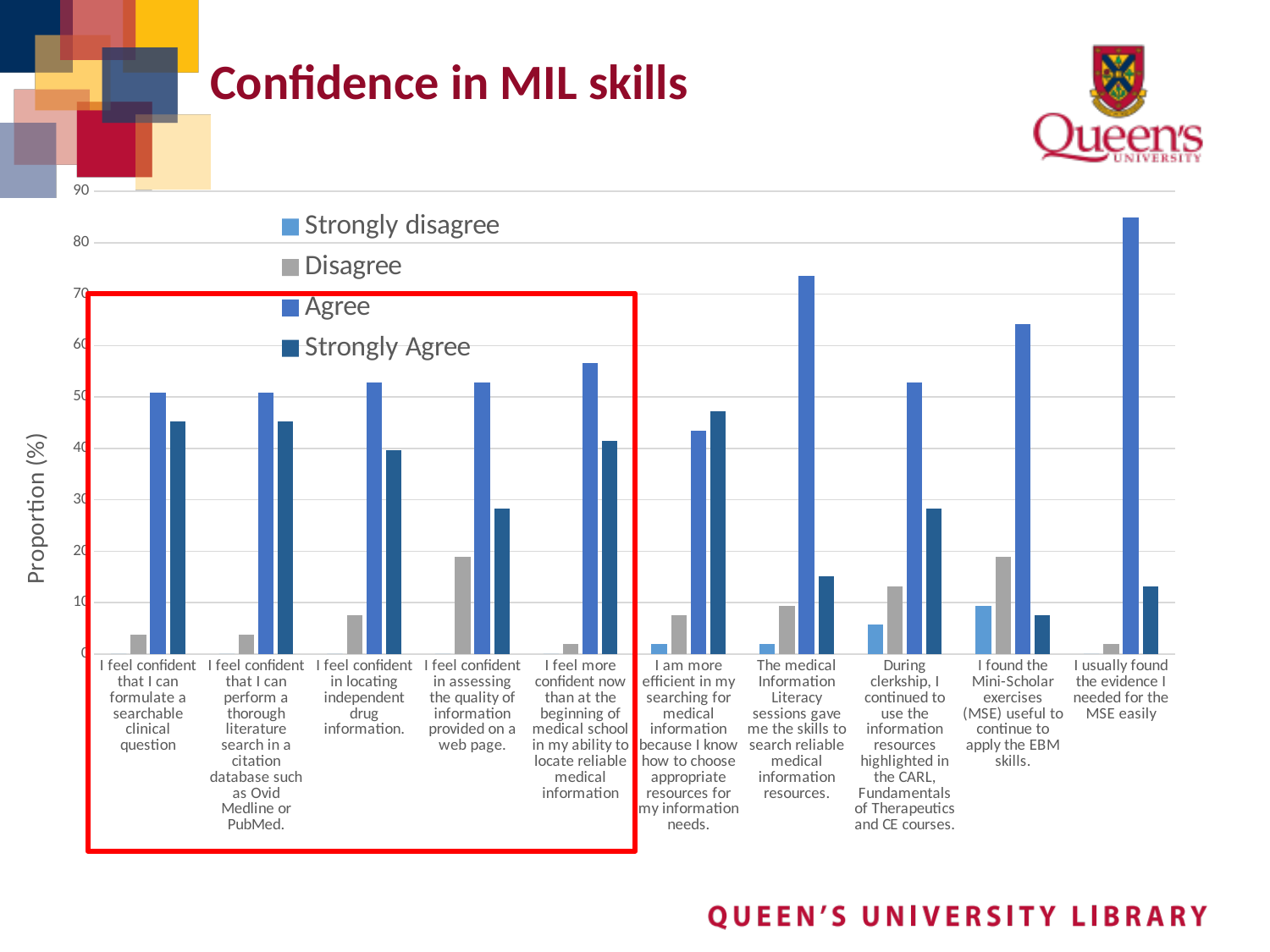
What kind of chart is shown on the slide? Bar chart What is the title of the chart? Confidence in MIL skills How many statement categories are plotted along the x axis? 10 How many series does the legend list? 4 Which statement has the highest Agree bar? I usually found the evidence I needed for the MSE easily Is the Agree value for "I usually found the evidence I needed for the MSE easily" greater or less than 80? greater Is the Agree value for "The medical Information Literacy sessions gave me the skills to search reliable medical information resources." greater or less than 70? greater Which has the larger Strongly Agree value: "I am more efficient in my searching for medical information because I know how to choose appropriate resources for my information needs." or "The medical Information Literacy sessions gave me the skills to search reliable medical information resources."? I am more efficient in my searching for medical information because I know how to choose appropriate resources for my information needs. Is the Strongly Agree value for "I feel confident that I can formulate a searchable clinical question" greater or less than 40? greater What is the label on the vertical axis? Proportion (%) For "I feel more confident now than at the beginning of medical school in my ability to locate reliable medical information", which is larger: the Agree value or the Strongly Agree value? Agree